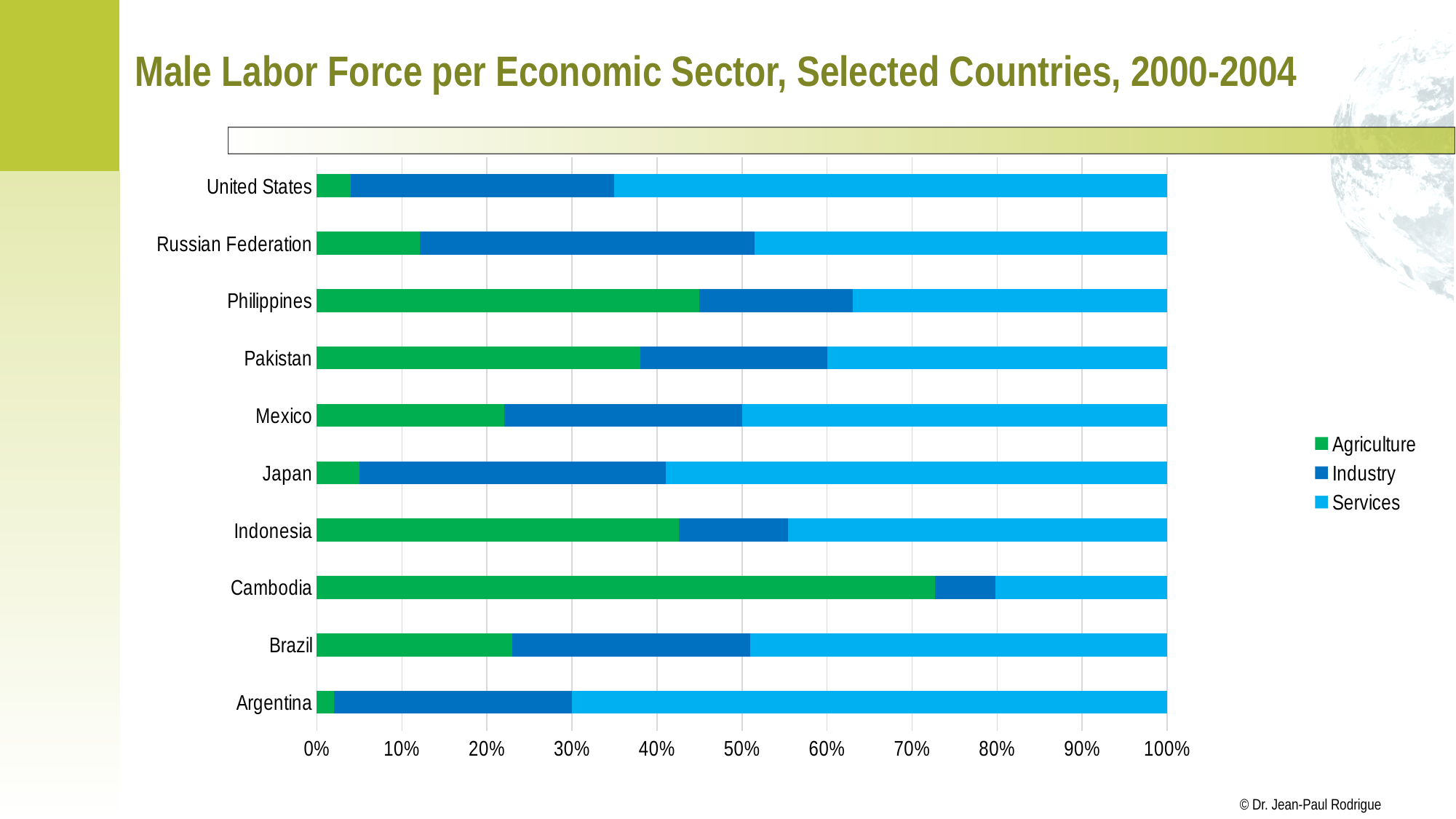
How many countries are shown on the chart? 10 What kind of chart is shown on the slide? Stacked bar chart Which country has the largest Agriculture share of the male labor force? Cambodia Which country has the largest Services share of the male labor force? Argentina Is the Agriculture share for Cambodia greater or less than 60%? greater What is the title of the chart? Male Labor Force per Economic Sector, Selected Countries, 2000-2004 Is the Agriculture share for the United States greater or less than 10%? less Which country has the smallest Industry share of the male labor force? Cambodia Which has a larger Agriculture share, the Philippines or Pakistan? Philippines How many series does the legend list? 3 Which country has the smallest Agriculture share of the male labor force? Argentina Which country has the smallest Services share of the male labor force? Cambodia